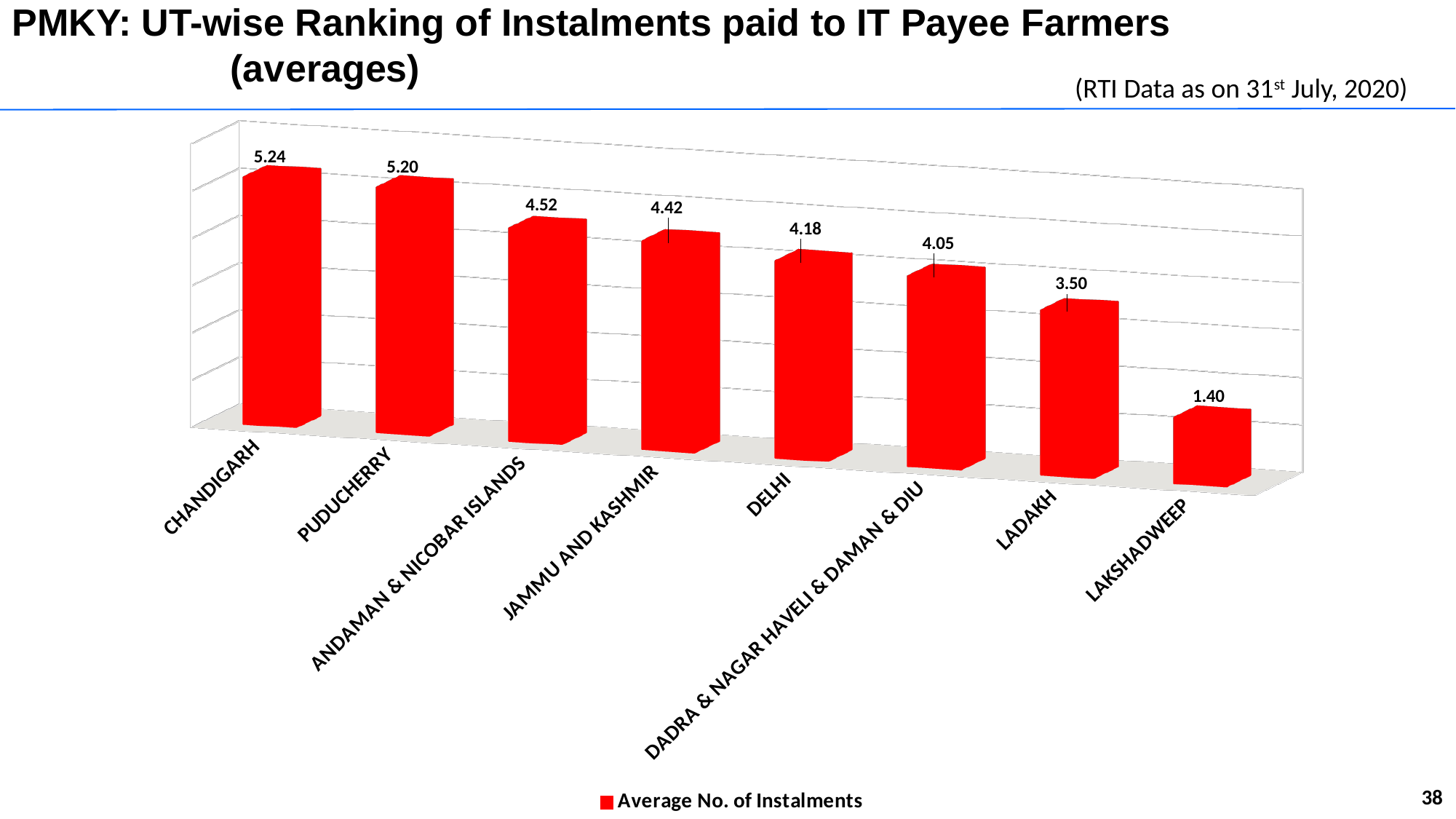
What is the average number of instalments for Delhi? 4.18 Which UT has the lowest average number of instalments? Lakshadweep How many UTs are shown in the chart? 8 Which UT has the highest average number of instalments? Chandigarh What is the difference between the average number of instalments for Chandigarh and Lakshadweep? 3.84 What is the average number of instalments for Dadra & Nagar Haveli & Daman & Diu? 4.05 What is the average number of instalments for Ladakh? 3.50 Which has a higher average number of instalments, Puducherry or Ladakh? Puducherry What is the difference between the average number of instalments for Andaman & Nicobar Islands and Jammu and Kashmir? 0.10 What is the average number of instalments for Chandigarh? 5.24 What kind of chart is shown on the slide? Bar chart Do the values rise or fall from left to right across the chart? Fall